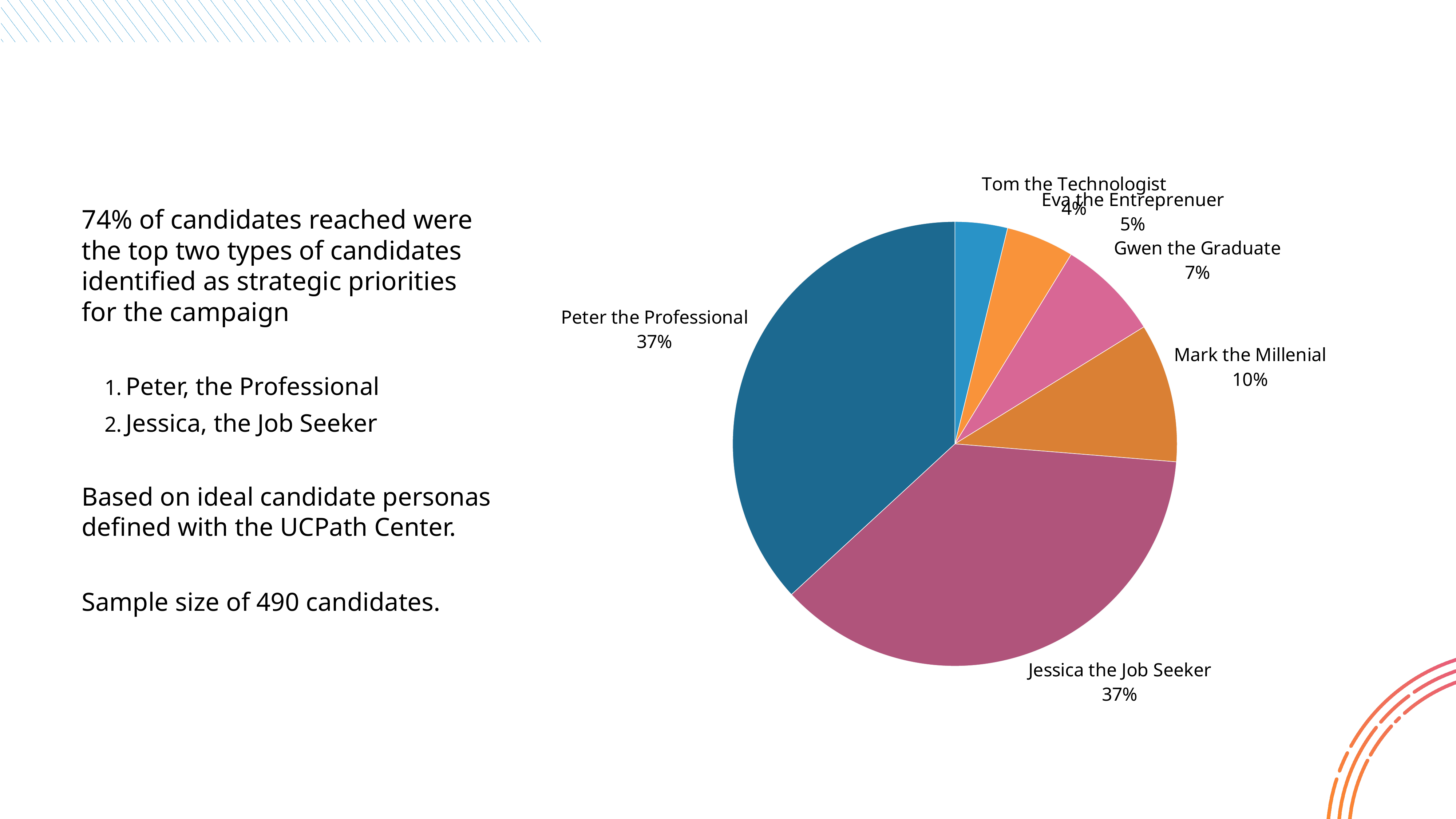
Which persona has the smallest slice of the pie? Tom the Technologist What kind of chart is shown on the slide? pie chart What is the value shown for Eva the Entreprenuer? 5% What is the value shown for Tom the Technologist? 4% What share of the pie does Peter the Professional represent? 37% What share of the pie does Jessica the Job Seeker represent? 37% How many slices does the pie chart have? 6 What is the difference between the values for Mark the Millenial and Gwen the Graduate? 3% What is the combined share of Peter the Professional and Jessica the Job Seeker? 74% Which is larger, the slice for Mark the Millenial or the slice for Gwen the Graduate? Mark the Millenial What is the value shown for Mark the Millenial? 10% What is the value shown for Gwen the Graduate? 7%